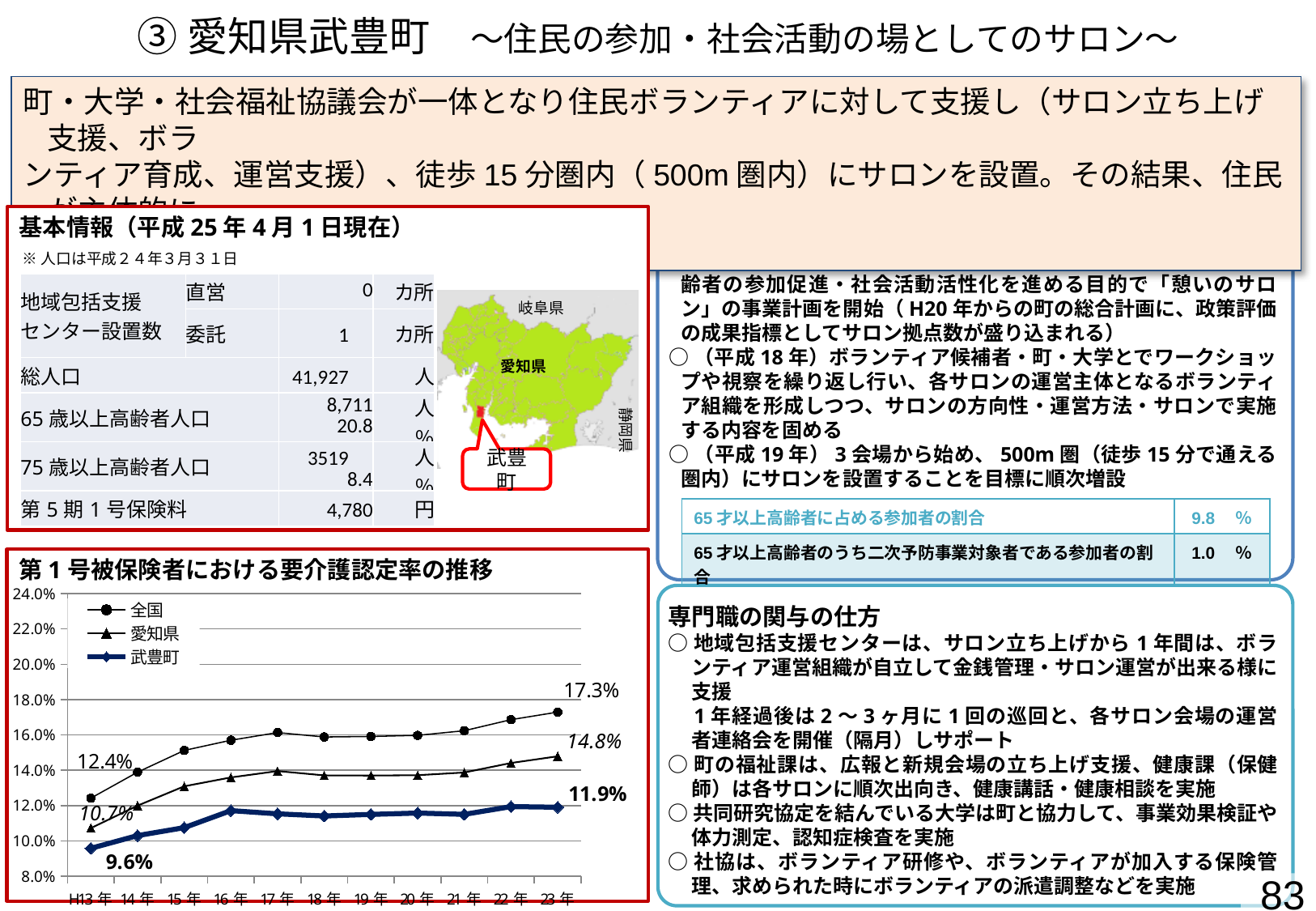
In the 要介護認定率の推移 chart, what is the value for 武豊町 at H23年? 11.9% In the 要介護認定率の推移 chart, is the value for 愛知県 at H18年 greater or less than 12.0%? greater In the 要介護認定率の推移 chart, what is the value for 愛知県 at H23年? 14.8% In the 要介護認定率の推移 chart, what is the value for 全国 at H13年? 12.4% In the 要介護認定率の推移 chart, what is the value for 全国 at H23年? 17.3% In the 要介護認定率の推移 chart, which series has the highest value at H23年? 全国 What kind of chart is shown under the title 第1号被保険者における要介護認定率の推移? line chart In the 要介護認定率の推移 chart, what is the difference between the 全国 and 武豊町 values at H23年? 5.4% In the 要介護認定率の推移 chart, what is the value for 武豊町 at H13年? 9.6% Which series are listed in the legend of the 要介護認定率の推移 chart? 全国, 愛知県, 武豊町 In the 要介護認定率の推移 chart, does the 武豊町 series rise or fall from H13年 to H23年? rise How many series does the legend of the 要介護認定率の推移 chart list? 3